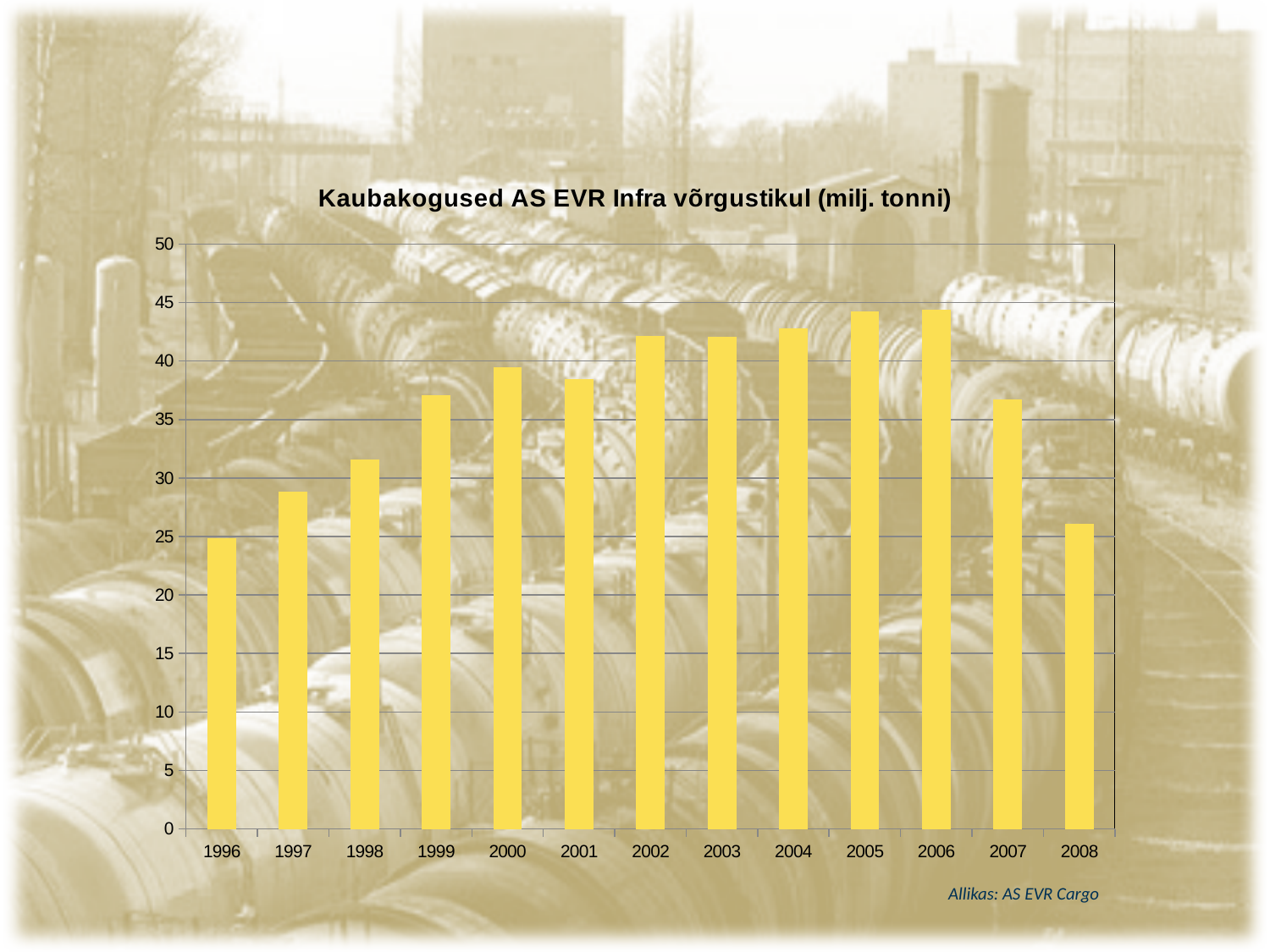
Do the values rise or fall from 1996 to 2000? rise Is the value for 1996 greater or less than 30? less How many years are shown on the x axis of the chart? 13 What source is cited below the chart? AS EVR Cargo What kind of chart is shown on the slide? bar chart Is the value for 2008 greater or less than 30? less Is the value for 2002 greater or less than 40? greater What is the title of the chart? Kaubakogused AS EVR Infra võrgustikul (milj. tonni) Which year has the larger value, 1998 or 1999? 1999 Which year has the larger value, 2006 or 2008? 2006